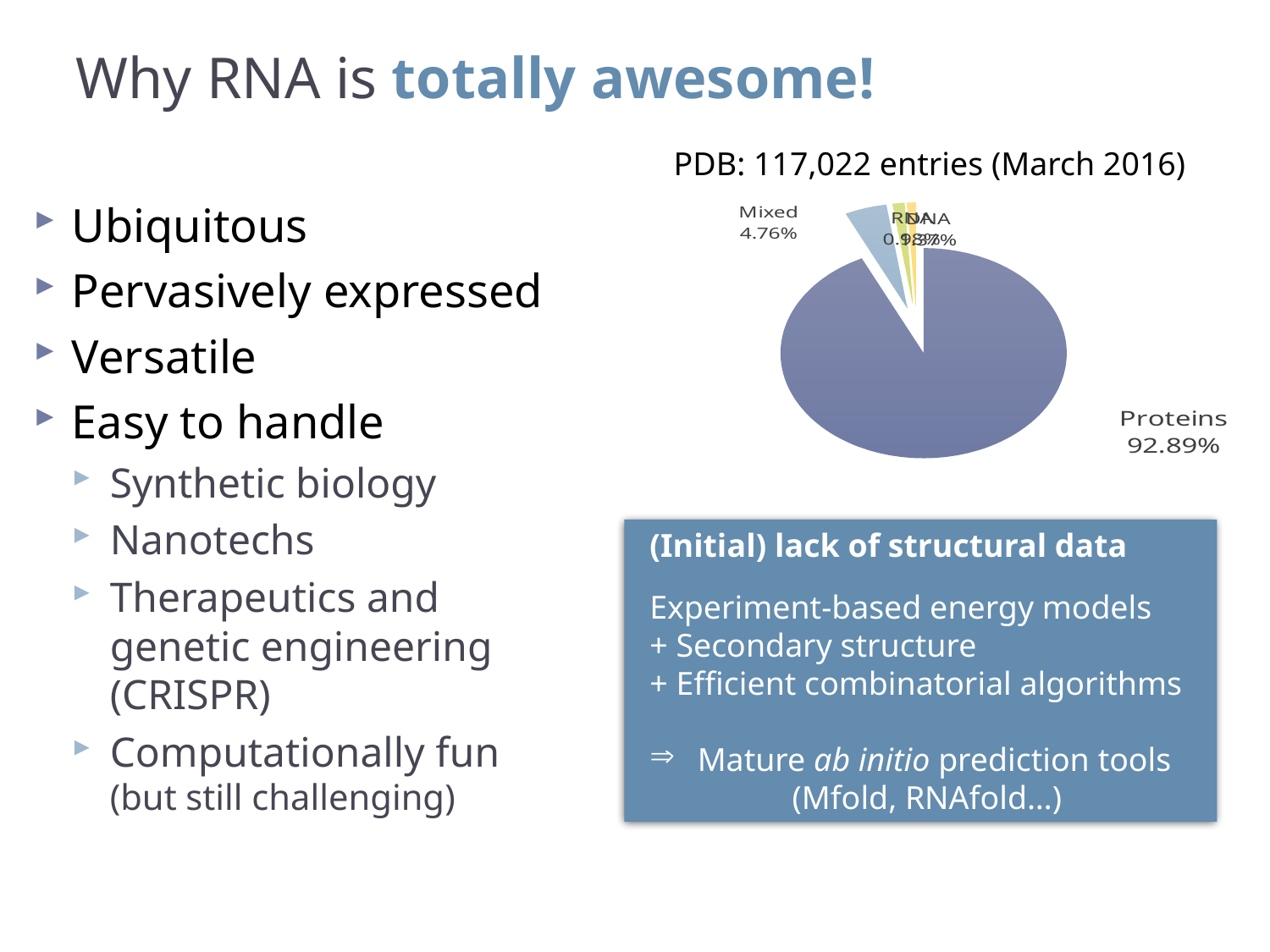
Which category has the largest slice in the pie chart? Proteins What is the title of the pie chart? PDB: 117,022 entries (March 2016) What colour is the Proteins slice in the pie chart? purple What kind of chart is shown on the slide? pie chart What share of the pie does the Mixed slice represent? 4.76% What percentage of PDB entries are Mixed according to the pie chart? 4.76% How many slices does the pie chart have? 4 What percentage of PDB entries are Proteins according to the pie chart? 92.89% What is the difference in percentage points between the Proteins slice and the Mixed slice? 88.13% Which slice is larger, Proteins or Mixed? Proteins